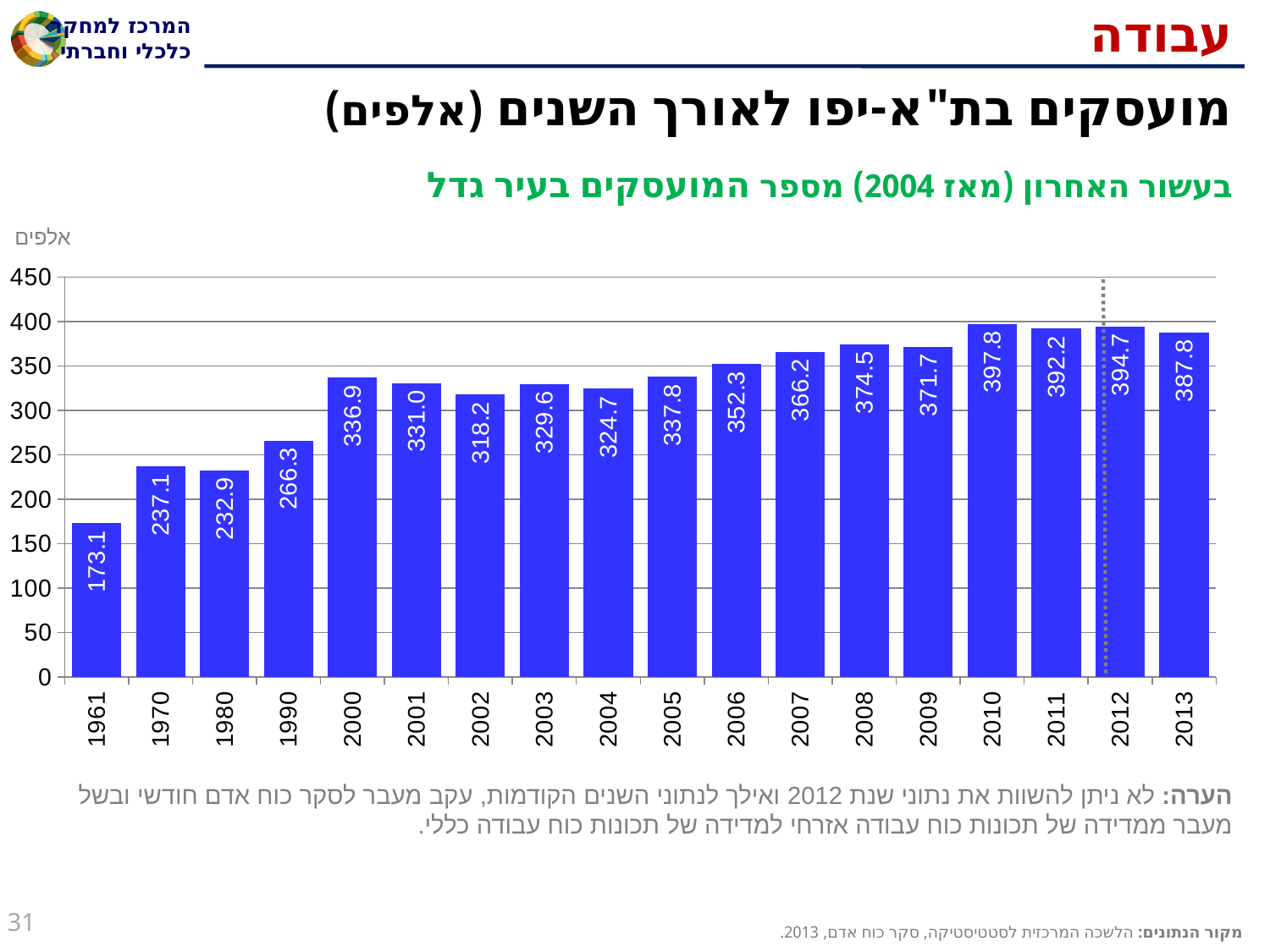
How many years are shown on the x axis? 18 What is the value for 2010? 397.8 What kind of chart is shown on the slide? Bar chart What is the difference between the values for 2000 and 1990? 70.6 What unit is shown on the y axis label? אלפים What is the difference between the values for 2013 and 2012? 6.9 Is the value for 2006 greater or less than 350? greater What is the value for 1961? 173.1 Which year has the lowest value? 1961 Which is larger, the value for 1970 or the value for 1980? 1970 What is the value for 2004? 324.7 Which year has the highest value? 2010